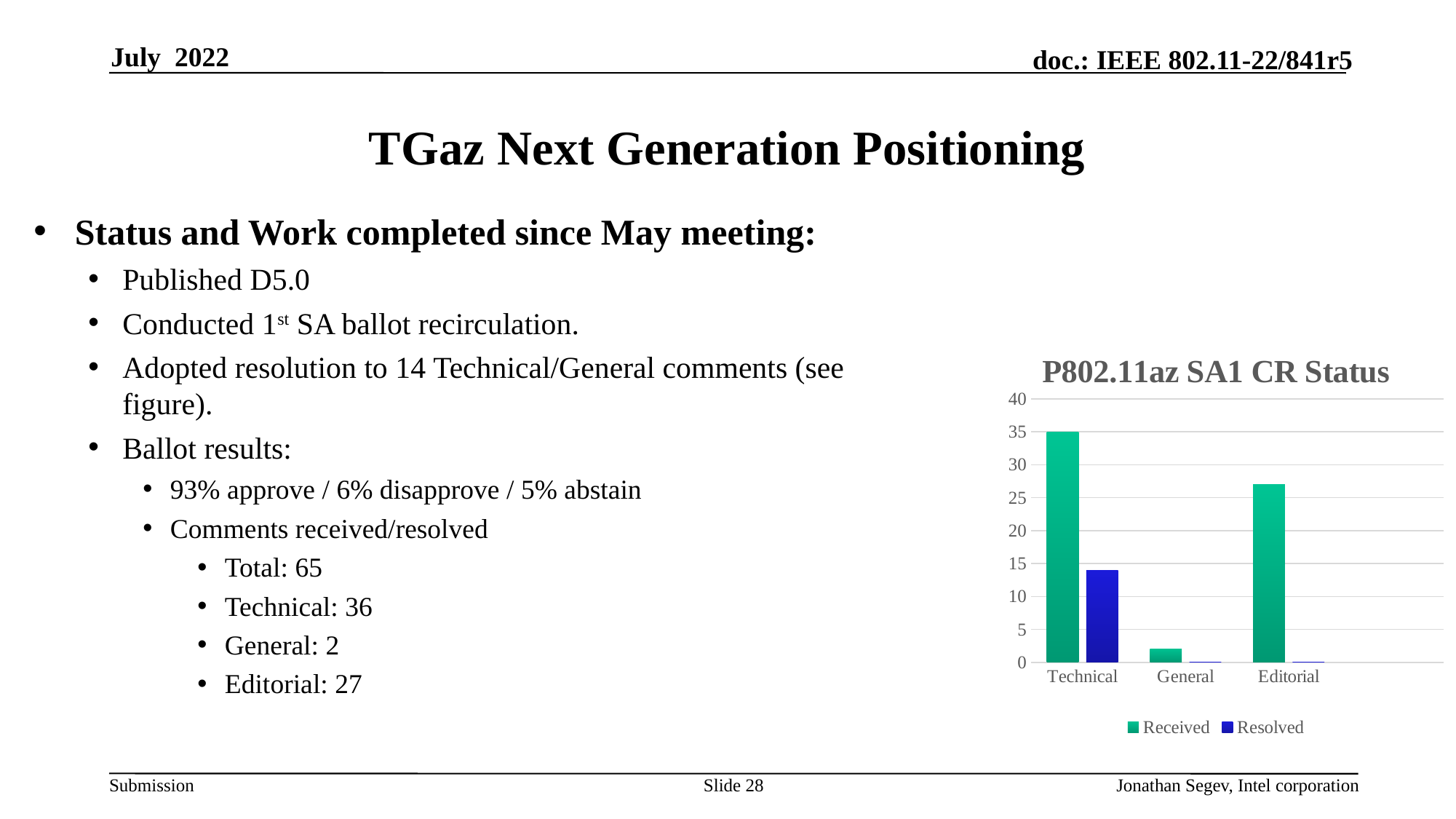
How many series does the chart legend list? 2 What kind of chart is shown on the slide? bar chart Is the Received value for Editorial greater or less than 25? greater What are the two series named in the chart legend? Received and Resolved Which is larger, the Received value for Technical or the Received value for Editorial? Technical What is the title of the chart? P802.11az SA1 CR Status Which category has the lowest Received value? General Which category has the highest Received value? Technical Is the Resolved value for Technical greater or less than 10? greater Is the Received value for General greater or less than 5? less How many categories are shown on the x axis of the chart? 3